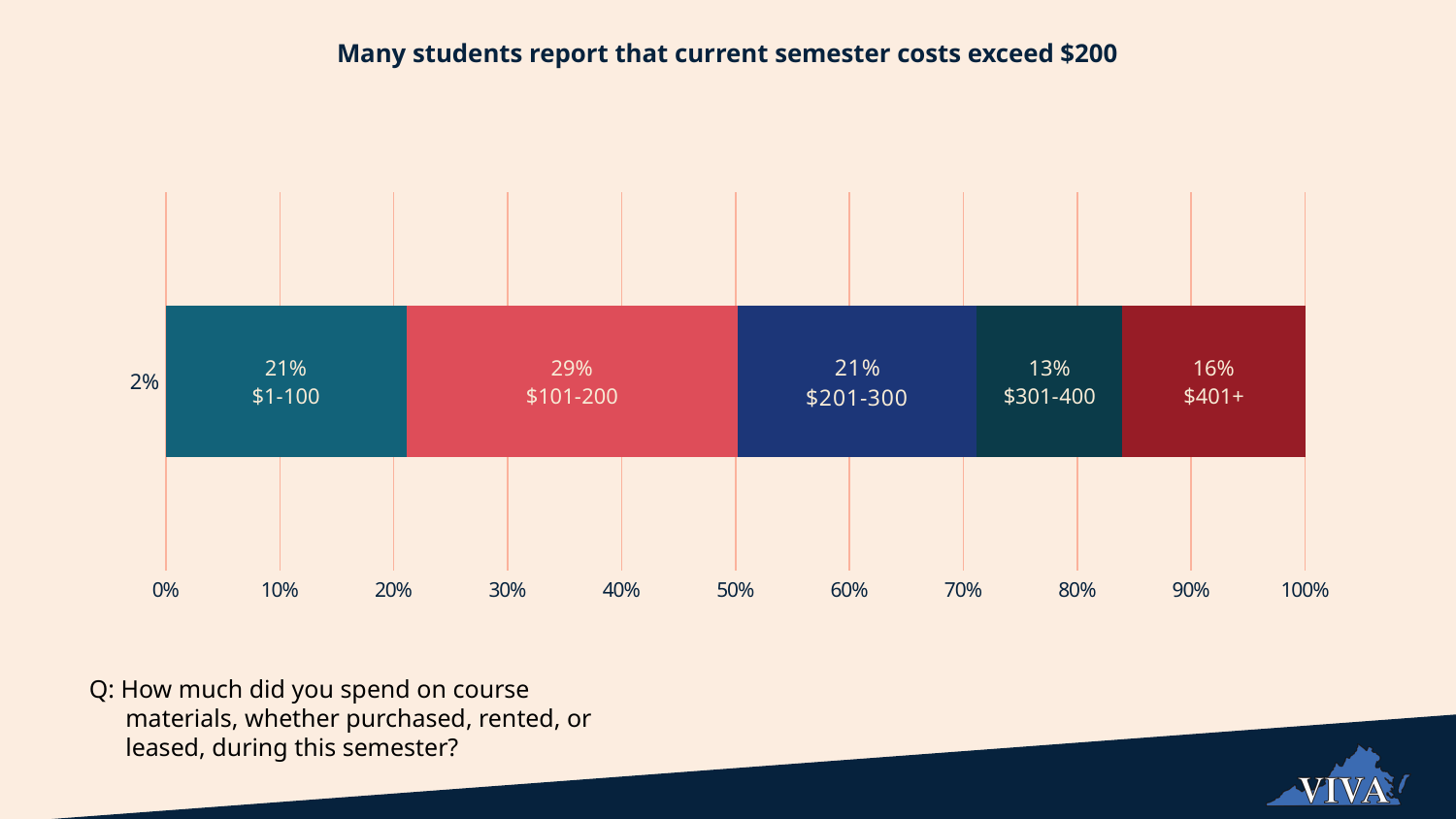
What is the difference in percentage points between the $101-200 segment and the $301-400 segment? 16 percentage points Among the segments labeled with a dollar range, which has the smallest share? $301-400 What percentage of students spent $101-200 on course materials this semester? 29% What type of chart is shown on the slide? Stacked horizontal bar chart What is the title of the chart? Many students report that current semester costs exceed $200 Which is larger, the share for $401+ or the share for $301-400? $401+ Which spending range has the largest share of students? $101-200 What percentage of students spent $401+? 16% What is the combined percentage of students who spent more than $200 ($201-300, $301-400 and $401+)? 50% How many segments in the bar are labeled with a dollar range? 5 What percentage of students spent $301-400? 13% What percentage of students spent $1-100? 21%